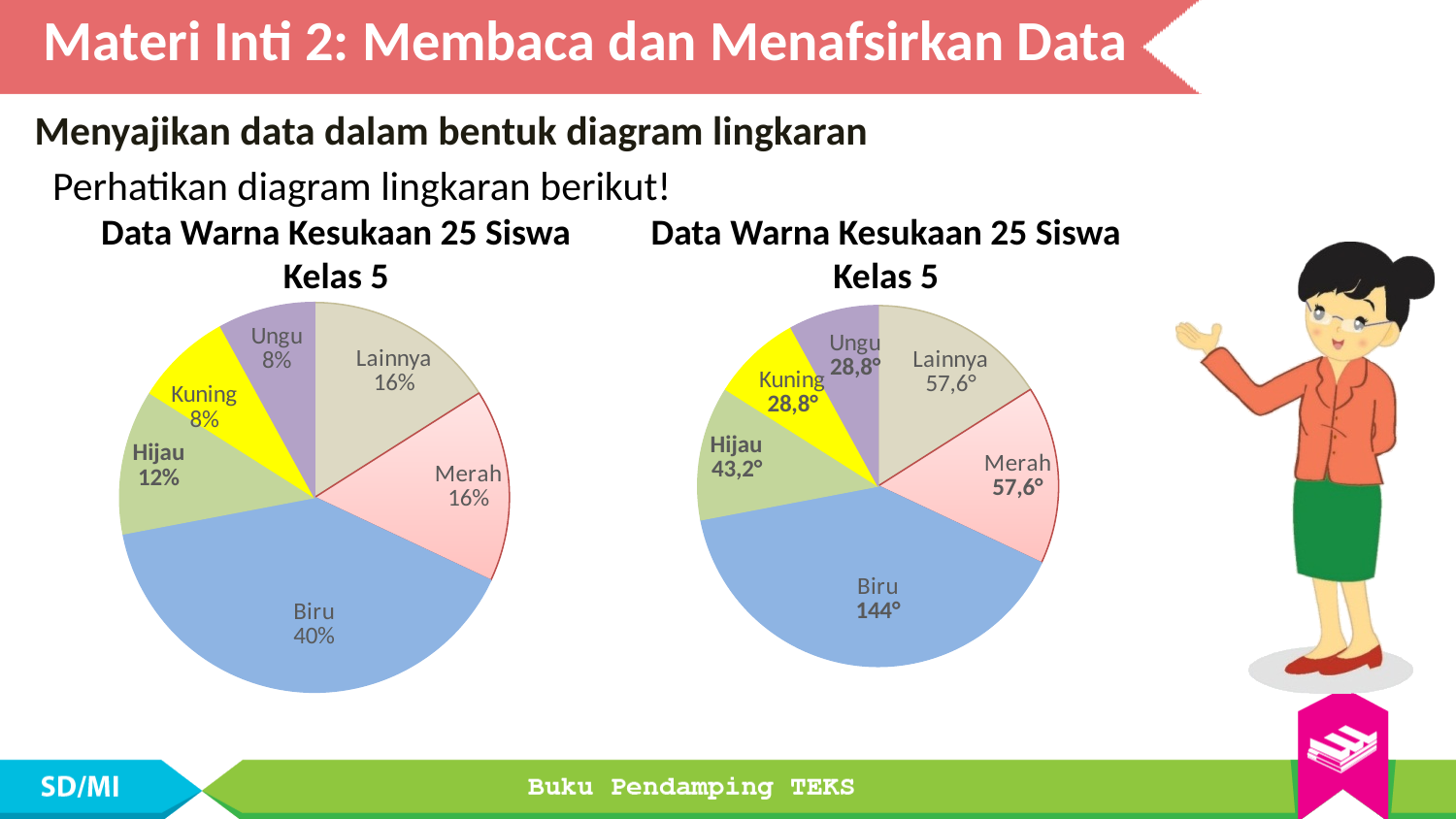
In the left pie chart, what is the difference between the percentages for Biru and Merah? 24% In the right pie chart, what angle is shown for Kuning? 28,8° In the left pie chart, what percentage is shown for Biru? 40% In the right pie chart, which category has the largest angle? Biru What type of chart is shown on the right side of the slide? Pie chart In the right pie chart, what angle is shown for Biru? 144° In the right pie chart, what angle is shown for Hijau? 43,2° In the left pie chart, what percentage is shown for Hijau? 12% In the left pie chart, which is larger, the share for Hijau or the share for Ungu? Hijau In the right pie chart, what is the difference between the angles for Merah and Hijau? 14,4° In the left pie chart, which colour has the largest share? Biru How many slices does the left pie chart have? 6